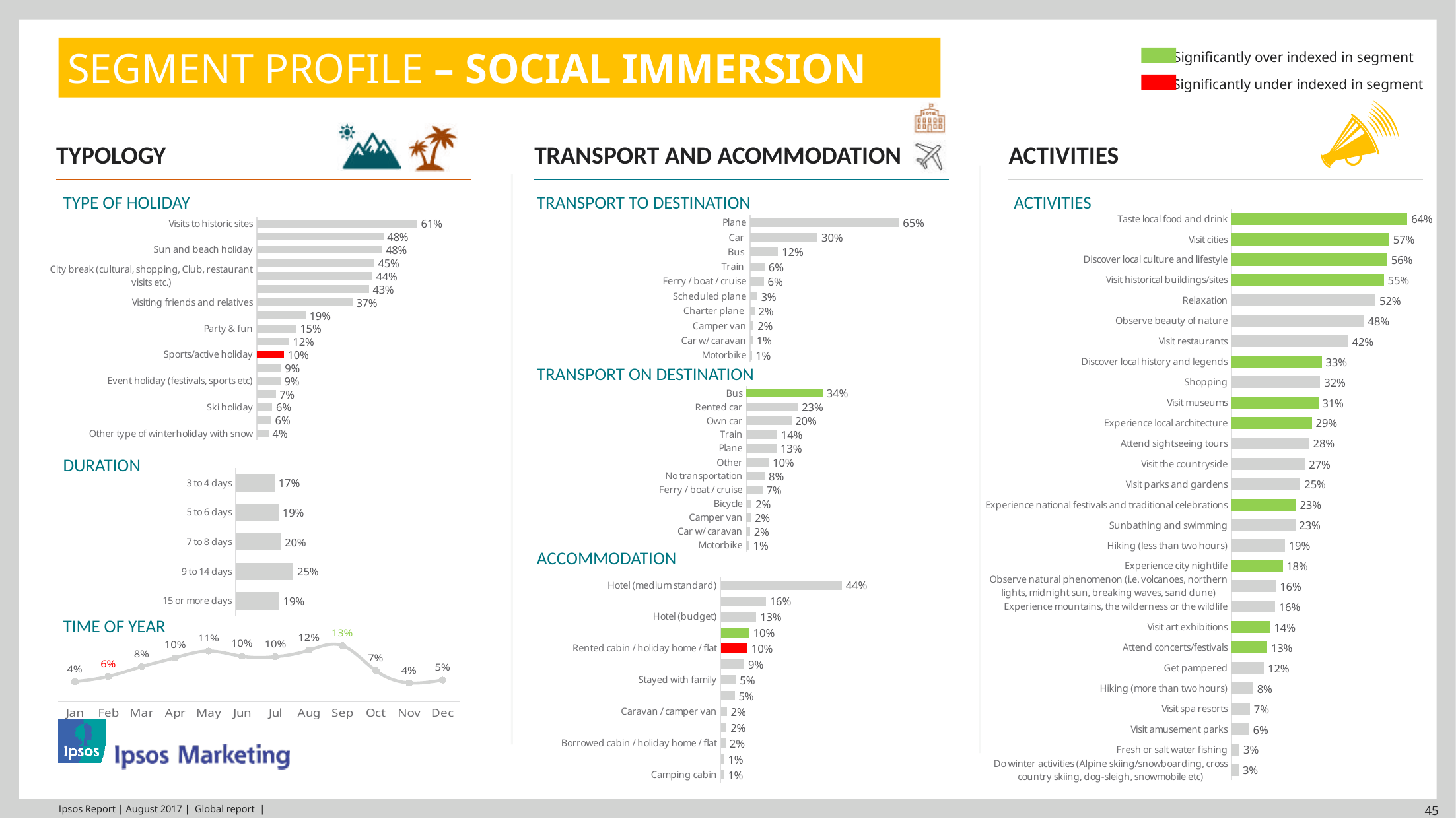
In the Type of Holiday chart, what is the difference between Sun and beach holiday and Visiting friends and relatives? 11% In the Activities chart, what is the difference between Taste local food and drink and Visit cities? 7% In the Activities chart, what is the value for Visit museums? 31% What kind of chart is the Time of Year chart? Line chart In the Transport to Destination chart, what is the value for Car? 30% In the Accommodation chart, what is the value for Hotel (medium standard)? 44% In the Transport on Destination chart, which category has the highest value? Bus In the Type of Holiday chart, what is the value for Visits to historic sites? 61% In the Time of Year chart, which month has the highest value? Sep In the Duration chart, how many categories are shown? 5 In the Duration chart, which category has the highest value? 9 to 14 days In the Transport on Destination chart, which is larger, Rented car or Own car? Rented car